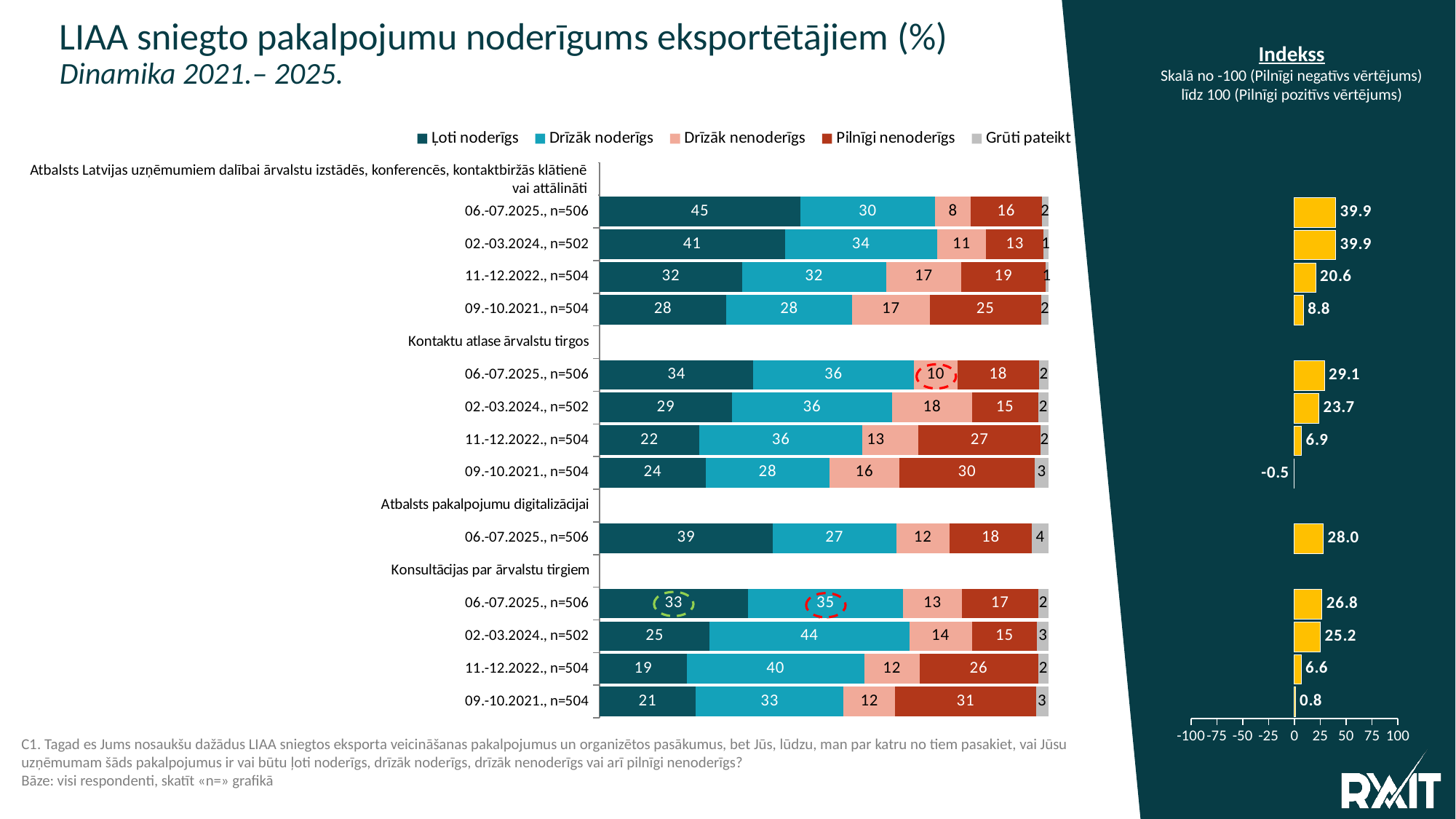
In the Indekss chart, what is the index value for "Atbalsts pakalpojumu digitalizācijai" in 06.-07.2025? 28.0 How many series does the legend of the stacked bar chart list? 5 In the stacked bar chart, how many bars are shown for "Atbalsts pakalpojumu digitalizācijai"? 1 In the stacked bar chart, for "Kontaktu atlase ārvalstu tirgos", which wave has the larger "Pilnīgi nenoderīgs" value: 09.-10.2021 or 06.-07.2025? 09.-10.2021 In the stacked bar chart, what is the total of the bar for "Atbalsts pakalpojumu digitalizācijai" in 06.-07.2025? 100 In the Indekss chart, which service and wave has the lowest index value? Kontaktu atlase ārvalstu tirgos, 09.-10.2021 (-0.5) What kind of chart is used on the left side of the slide? Stacked bar chart In the stacked bar chart, what is the "Drīzāk noderīgs" value for "Konsultācijas par ārvalstu tirgiem" in 02.-03.2024? 44 In the stacked bar chart, what is the difference between the "Ļoti noderīgs" values for "Konsultācijas par ārvalstu tirgiem" in 06.-07.2025 and 09.-10.2021? 12 In the Indekss chart on the right, what is the index value for "Kontaktu atlase ārvalstu tirgos" in 09.-10.2021? -0.5 In the Indekss chart, does the index for "Konsultācijas par ārvalstu tirgiem" rise or fall from 09.-10.2021 to 06.-07.2025? Rises In the stacked bar chart, what is the "Ļoti noderīgs" value for "Atbalsts Latvijas uzņēmumiem dalībai ārvalstu izstādēs, konferencēs, kontaktbiržās klātienē vai attālināti" in 06.-07.2025? 45